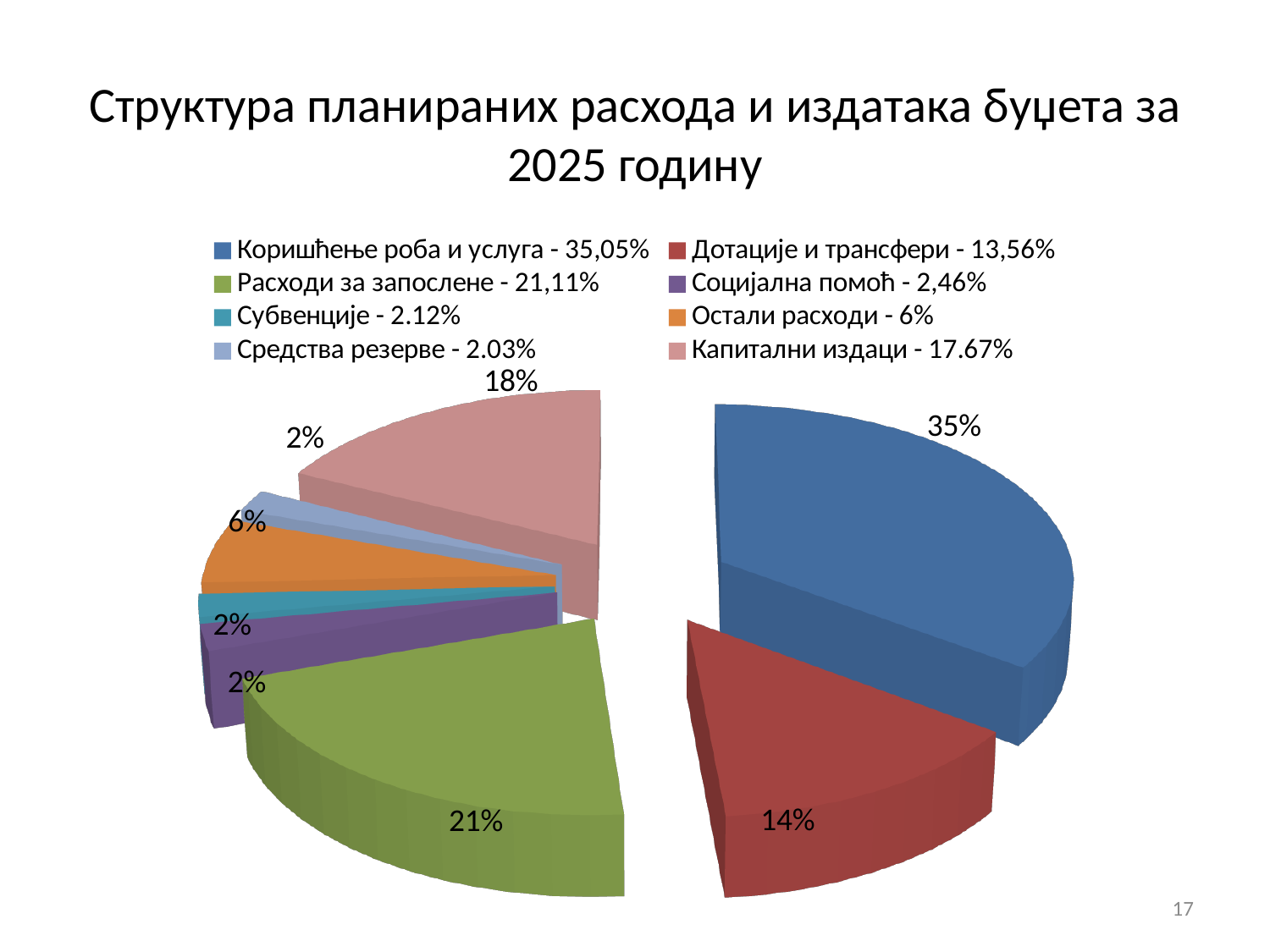
How many slices does the pie chart have? 8 What kind of chart is shown on the slide? pie chart Using the data labels, what is the difference between the Коришћење роба и услуга slice (35%) and the Дотације и трансфери slice (14%)? 21% What is the title of the chart on the slide? Структура планираних расхода и издатака буџета за 2025 годину What percentage is shown on the data label for the Коришћење роба и услуга slice? 35% What colour is the Остали расходи slice in the pie chart? orange Which is larger, the share of Расходи за запослене or the share of Капитални издаци? Расходи за запослене Which category has the largest share of the pie? Коришћење роба и услуга How many entries does the legend of the pie chart list? 8 According to the legend values, which category has the smallest share? Средства резерве What percentage is shown on the data label for the Капитални издаци slice? 18% According to the legend, what is the share of Дотације и трансфери? 13,56%